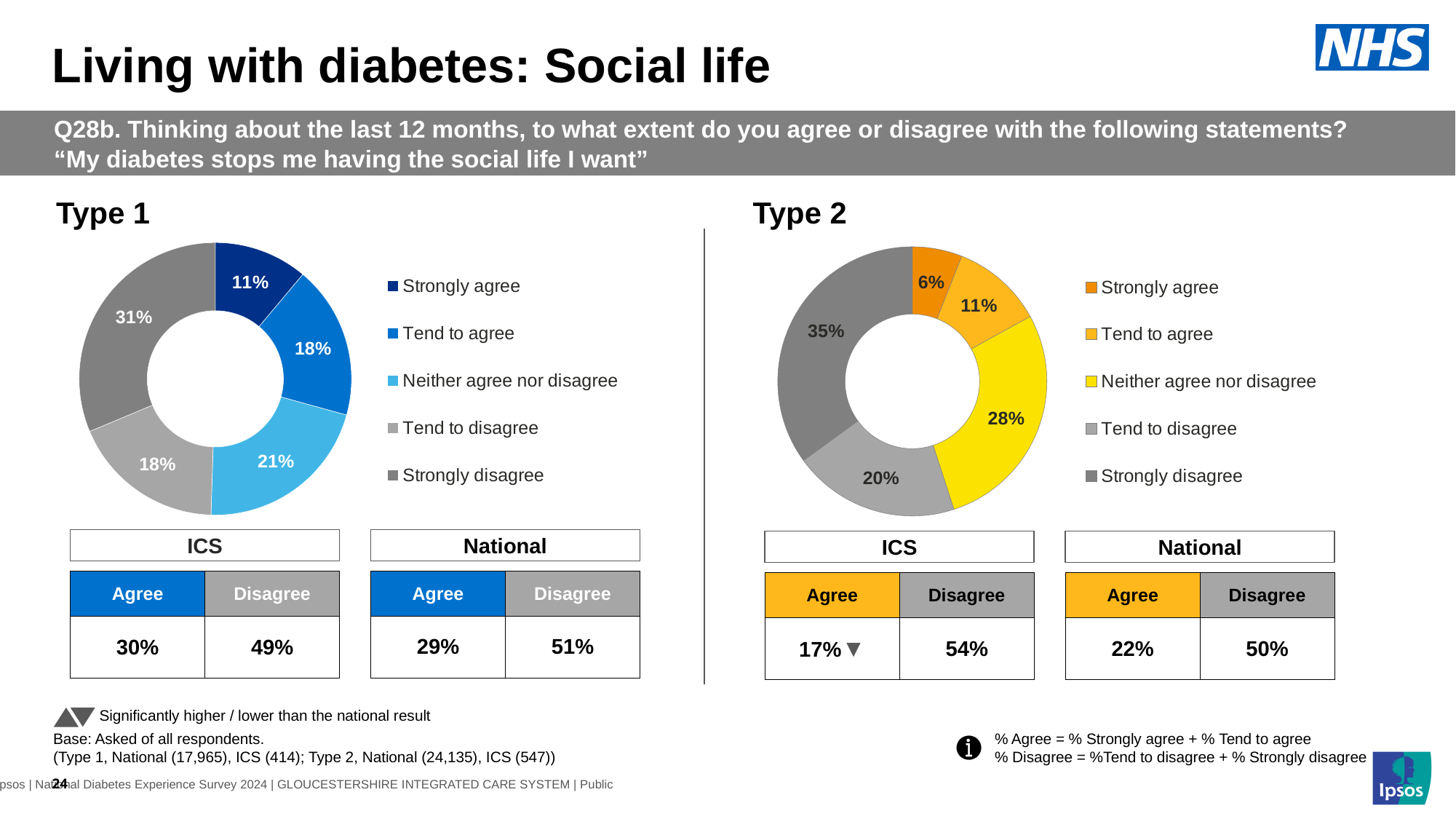
In the Type 2 chart, what is the difference between the Strongly disagree share and the Tend to disagree share? 15% In the Type 2 chart, what colour is the Neither agree nor disagree segment? Yellow In the Type 2 chart, what percentage of respondents neither agree nor disagree? 28% How many response categories does the Type 1 chart's legend list? 5 In the Type 2 chart, what is the combined share of Strongly agree and Tend to agree? 17% In the Type 1 chart, what is the difference between the Strongly disagree share and the Strongly agree share? 20% What kind of chart is used for Type 1? Doughnut chart In the Type 1 chart, what percentage of respondents strongly agree? 11% In the Type 1 chart, which response category has the largest share? Strongly disagree In the Type 1 chart, which is larger: Tend to agree or Neither agree nor disagree? Neither agree nor disagree In the Type 2 chart, which response category has the smallest share? Strongly agree In the Type 1 chart, what is the combined share of Tend to disagree and Strongly disagree? 49%